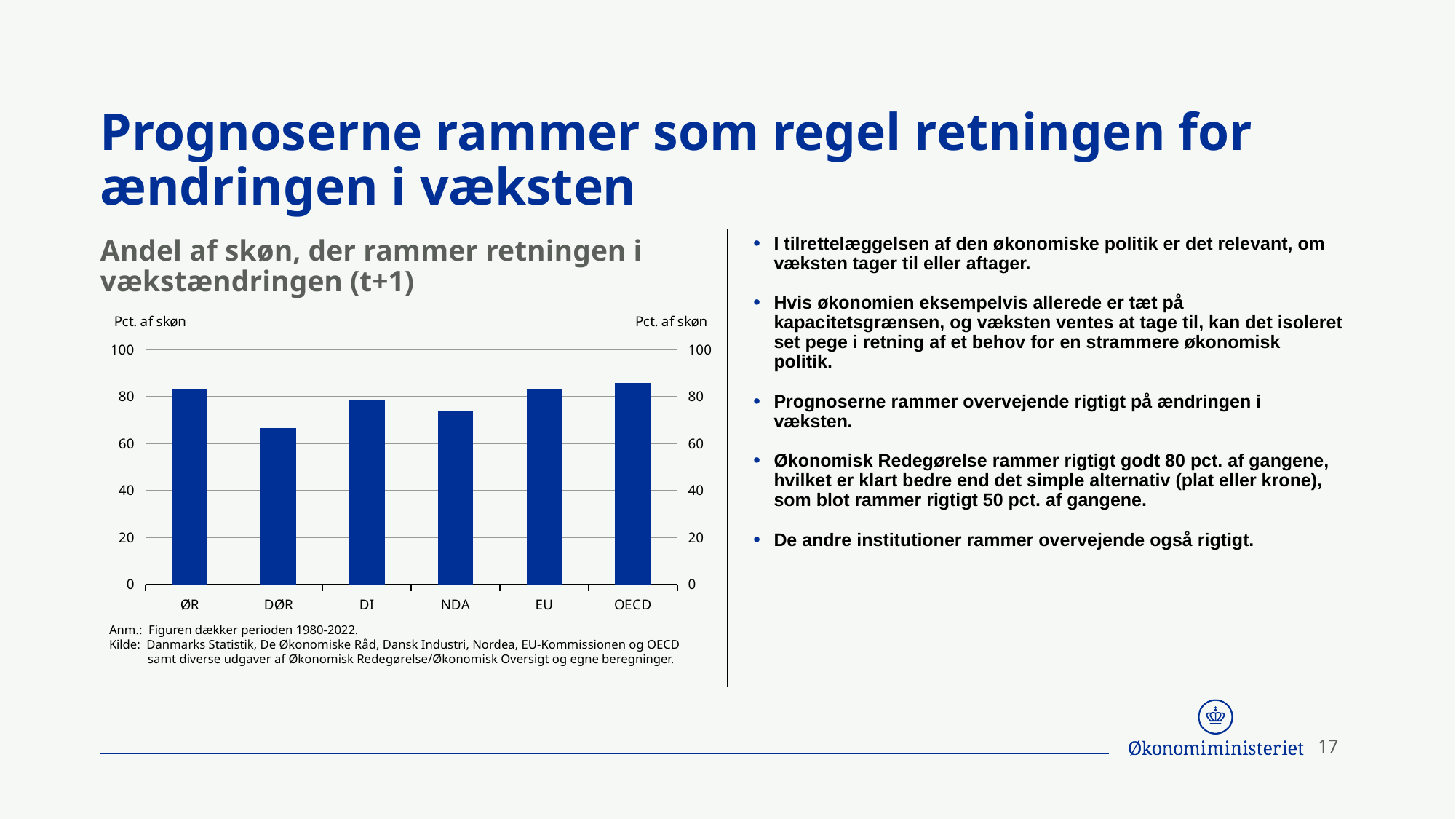
Which is larger, the value for DI or the value for DØR? DI Which is larger, the value for DØR or the value for NDA? NDA Which institution has the lowest share of forecasts hitting the direction of the growth change? DØR How many institutions (categories) are shown on the x axis of the chart? 6 Is the value for NDA greater or less than 80? less Is the value for OECD greater or less than 80? greater What unit label is shown on the y axis of the chart? Pct. af skøn What is the title of the chart? Andel af skøn, der rammer retningen i vækstændringen (t+1) Is the value for DØR greater or less than 80? less What kind of chart is shown on the slide? Bar chart Which institution has the highest share of forecasts hitting the direction of the growth change? OECD